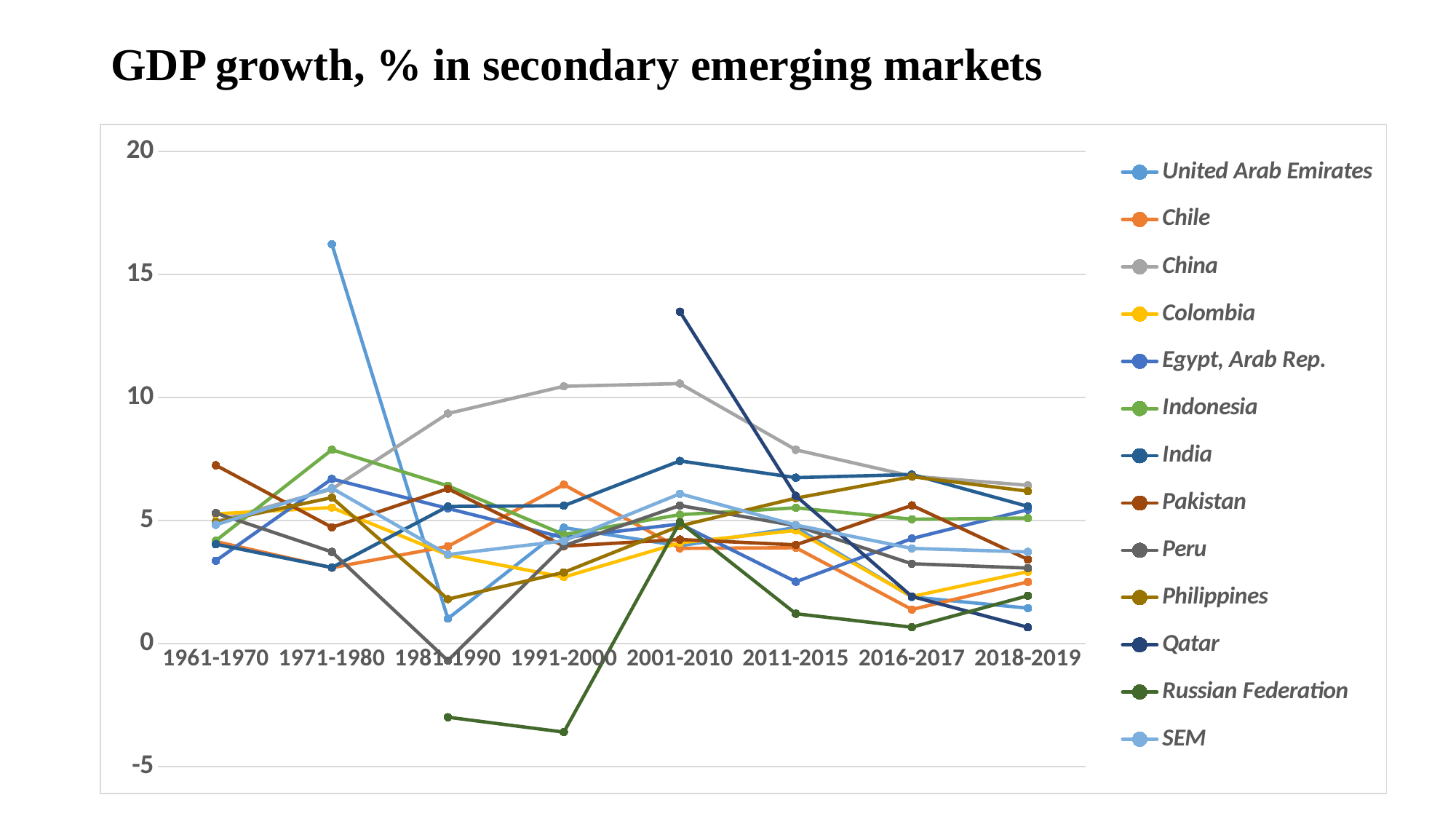
Is the value for Qatar in 2001-2010 greater or less than 10? greater Which series has the lowest value in the 1991-2000 period? Russian Federation What kind of chart is shown on the slide? line chart In the 1981-1990 period, which is larger, the value for China or the value for Peru? China Is the value for China in 1991-2000 greater or less than 10? greater Which series has the highest value in the 1971-1980 period? United Arab Emirates How many series does the legend list? 13 How many time periods are shown along the x axis? 8 Is the value for Russian Federation in 1991-2000 greater or less than 0? less What is the title of the chart? GDP growth, % in secondary emerging markets Does the value for China rise or fall from 2001-2010 to 2018-2019? fall